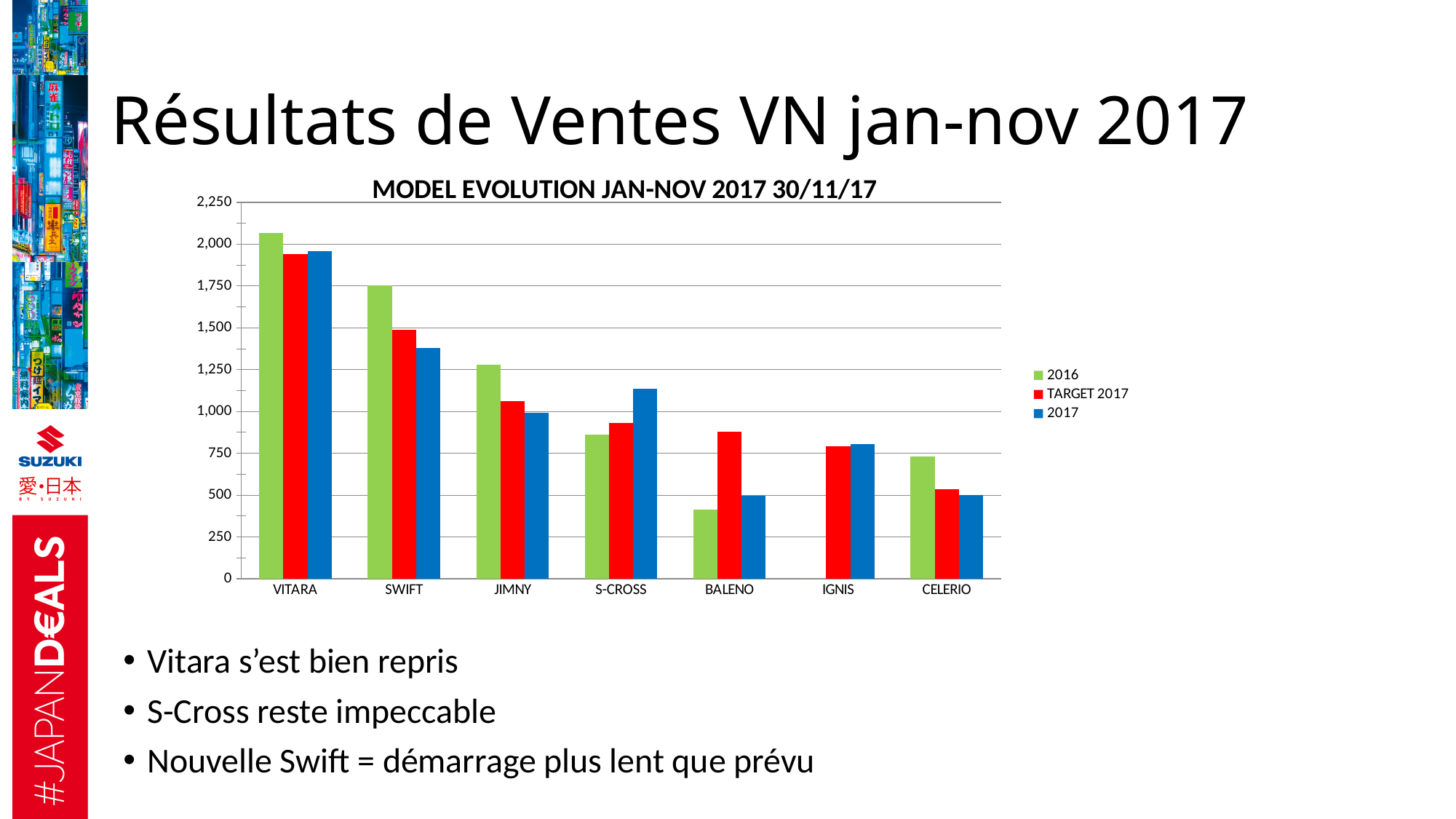
Which model has the lowest TARGET 2017 value? CELERIO How many series does the legend list? 3 Is the 2017 value for S-CROSS greater or less than 1,000? greater What is the title of the chart? MODEL EVOLUTION JAN-NOV 2017 30/11/17 Do the TARGET 2017 values rise or fall from VITARA to CELERIO along the x axis? fall For BALENO, which is larger: the TARGET 2017 value or the 2017 value? TARGET 2017 For S-CROSS, which is larger: the TARGET 2017 value or the 2017 value? 2017 What kind of chart is shown on the slide? bar chart How many model categories are shown on the x axis? 7 Which model has the highest 2016 value? VITARA Is the 2017 value for SWIFT greater or less than 1,500? less Is the 2016 value for VITARA greater or less than 2,000? greater